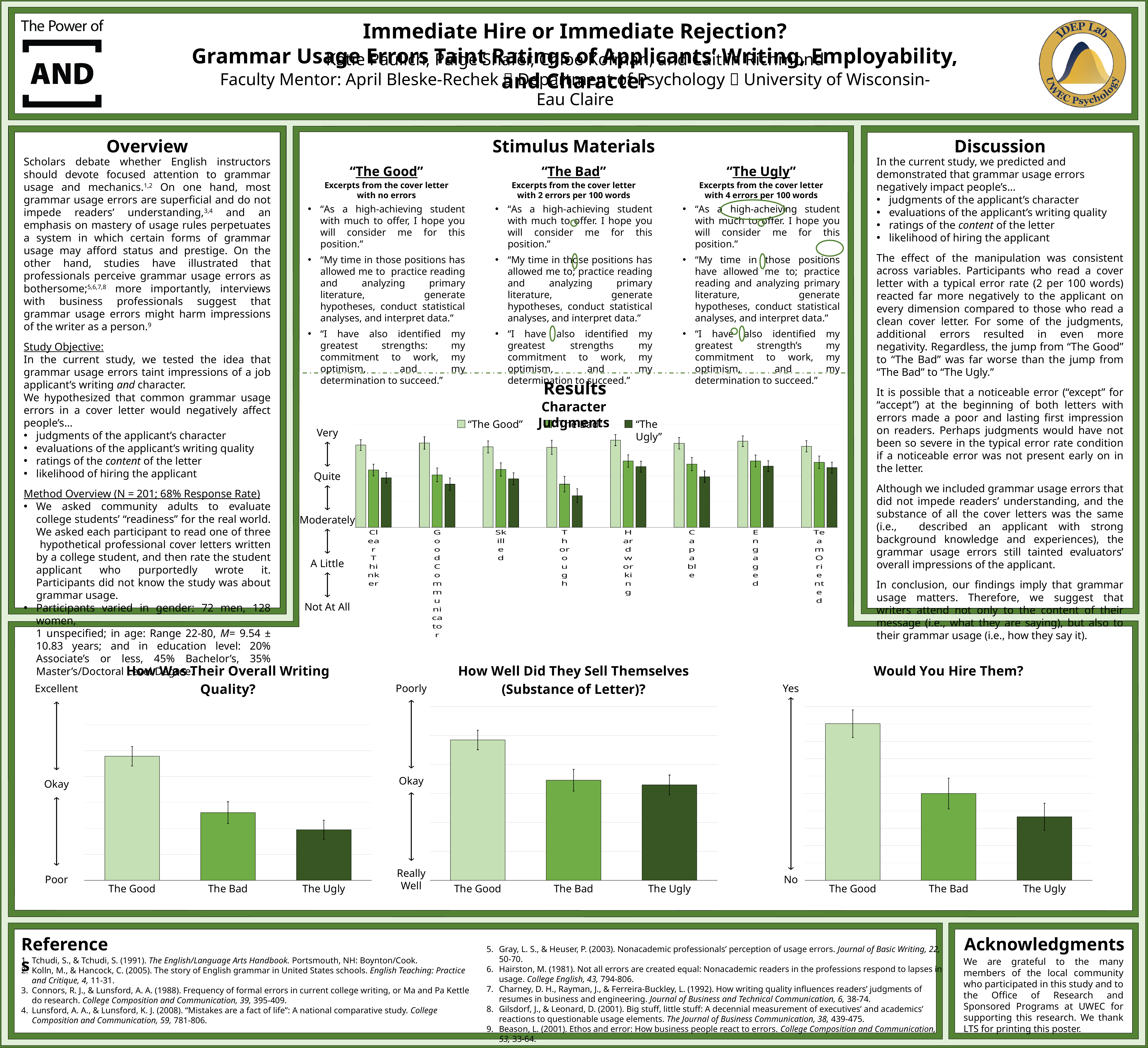
What kind of chart is the "Would You Hire Them?" chart? bar chart In the "Character Judgments" chart, for Hardworking, is the bar for The Good or The Ugly taller? The Good In the "Would You Hire Them?" chart, is the bar for The Bad or The Ugly taller? The Bad In the "How Well Did They Sell Themselves (Substance of Letter)?" chart, which category has the tallest bar? The Good How many categories are shown on the x axis of the "Character Judgments" chart? 8 How many categories are shown on the x axis of the "Would You Hire Them?" chart? 3 In the "How Was Their Overall Writing Quality?" chart, which category has the shortest bar? The Ugly In the "Character Judgments" chart, which series has the tallest bar for Clear Thinker? The Good How many series does the legend of the "Character Judgments" chart list? 3 In the "Character Judgments" chart, which series has the shortest bar for Thorough? The Ugly In the "How Was Their Overall Writing Quality?" chart, which category has the tallest bar? The Good In the "How Was Their Overall Writing Quality?" chart, do the bars rise or fall from The Good to The Ugly? fall